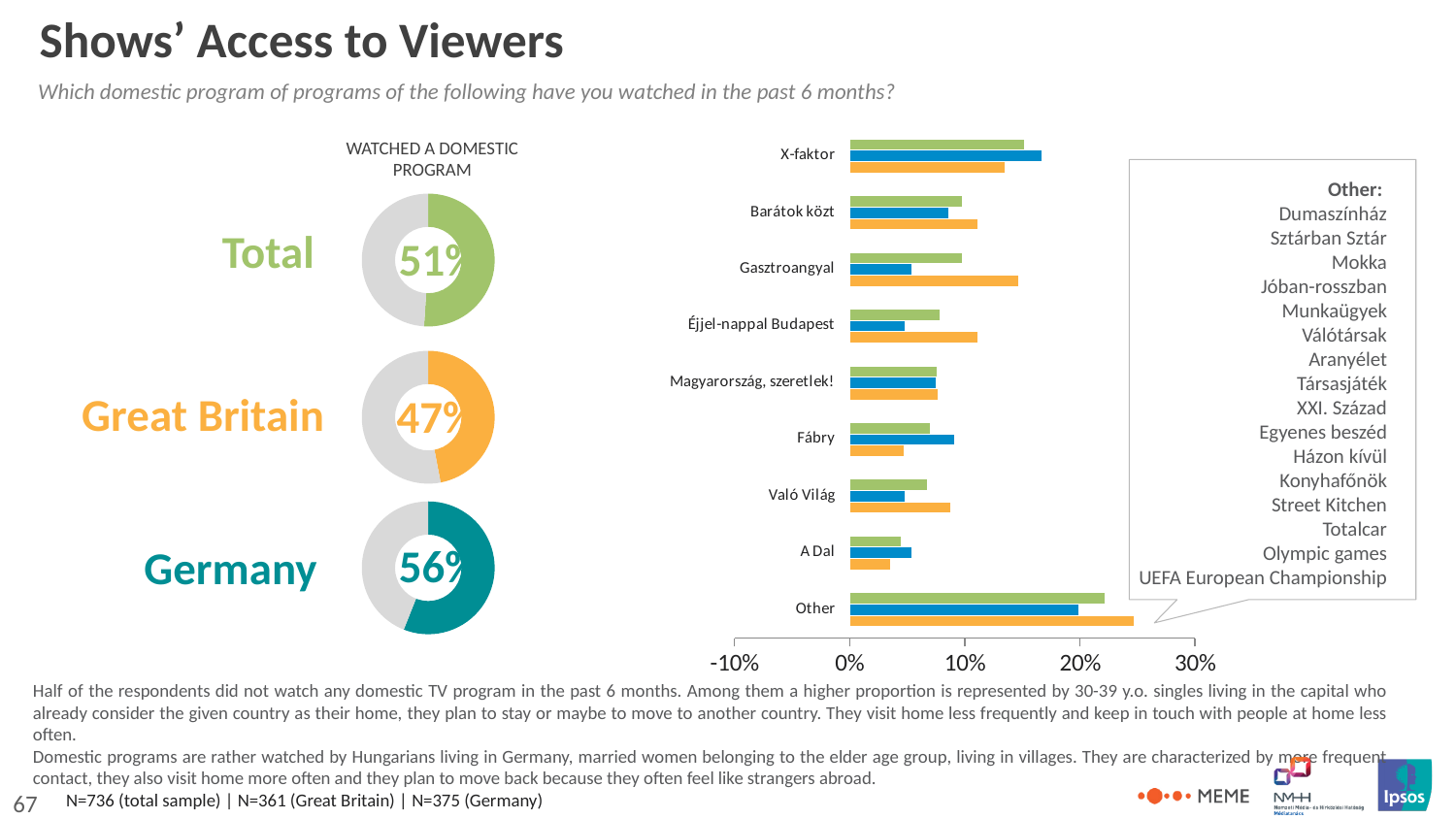
How many programs (categories) are listed in the bar chart on the right? 9 In the bar chart on the right, is the blue bar for X-faktor greater or less than 10%? greater What kind of chart is the program chart on the right of the slide? Bar chart In the donut charts on the left, what percentage of respondents in Great Britain watched a domestic program? 47% In the donut charts on the left, what percentage of the Total sample watched a domestic program? 51% Among the three donut charts on the left, which group has the lowest share that watched a domestic program? Great Britain In the bar chart on the right, how many bars are plotted for each program? 3 In the bar chart on the right, is the green bar for A Dal greater or less than 10%? less In the donut charts on the left, how many percentage points higher is Germany's share than Great Britain's? 9 percentage points Among the three donut charts on the left, which group has the highest share that watched a domestic program? Germany In the donut charts on the left, what percentage of respondents in Germany watched a domestic program? 56% In the bar chart on the right, for Gasztroangyal, which is larger: the orange bar or the blue bar? The orange bar